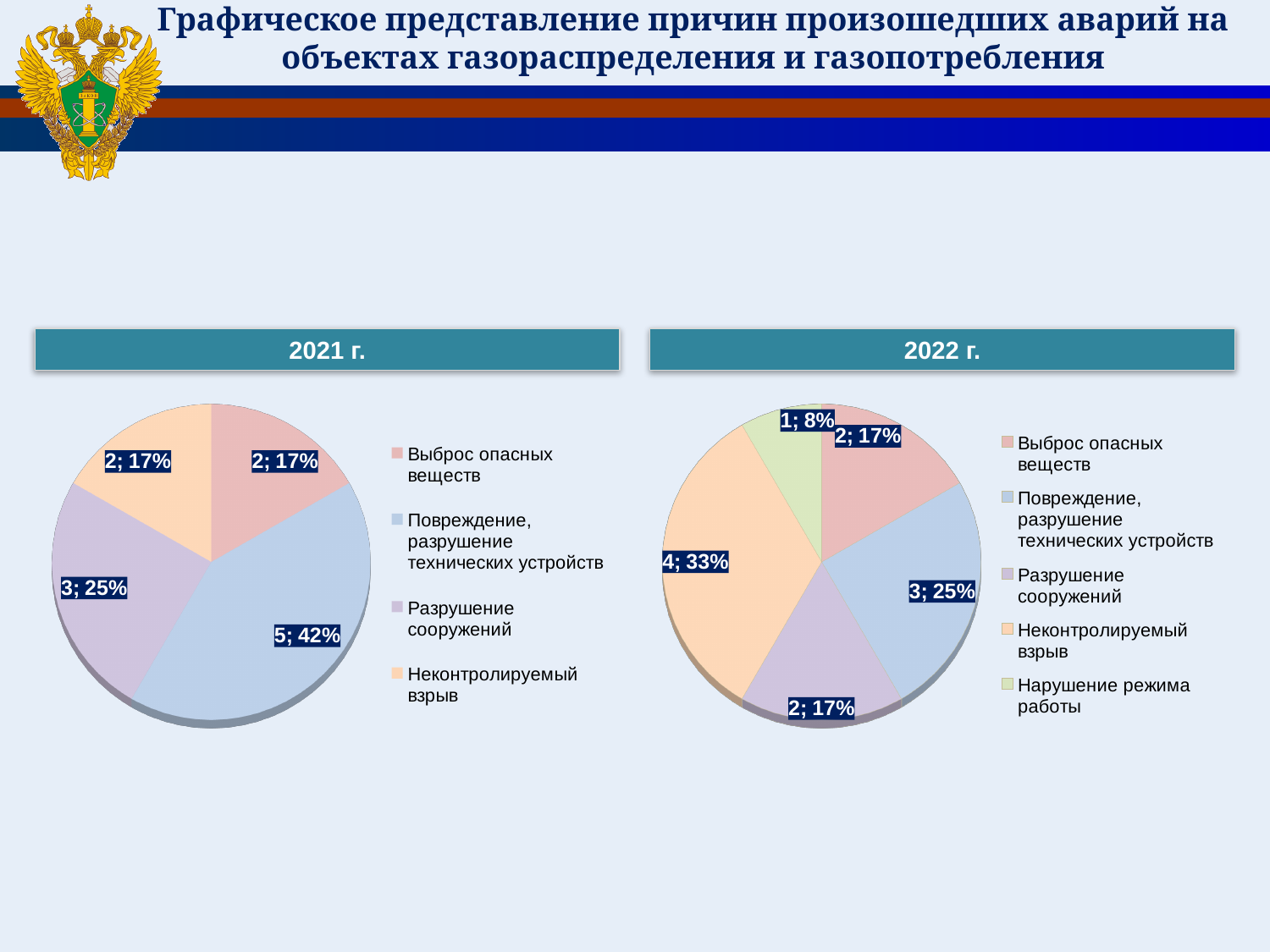
In the 2021 г. pie chart, what is the data label for Повреждение, разрушение технических устройств? 5; 42% How many categories does the legend of the 2021 г. pie chart list? 4 In the 2021 г. pie chart, which category has the largest slice? Повреждение, разрушение технических устройств In the 2021 г. pie chart, what share does Разрушение сооружений have? 25% Which is larger: the count for Неконтролируемый взрыв in the 2021 г. chart or in the 2022 г. chart? 2022 г. In the 2022 г. pie chart, what is the data label for Неконтролируемый взрыв? 4; 33% In the 2021 г. pie chart, what is the difference between the count for Повреждение, разрушение технических устройств and the count for Разрушение сооружений? 2 In the 2022 г. pie chart, which category has the smallest slice? Нарушение режима работы What type of chart is used for the 2022 г. data? Pie chart In the 2022 г. pie chart, what share does Повреждение, разрушение технических устройств have? 25% In the 2022 г. pie chart, which category has the largest slice? Неконтролируемый взрыв How many categories does the legend of the 2022 г. pie chart list? 5